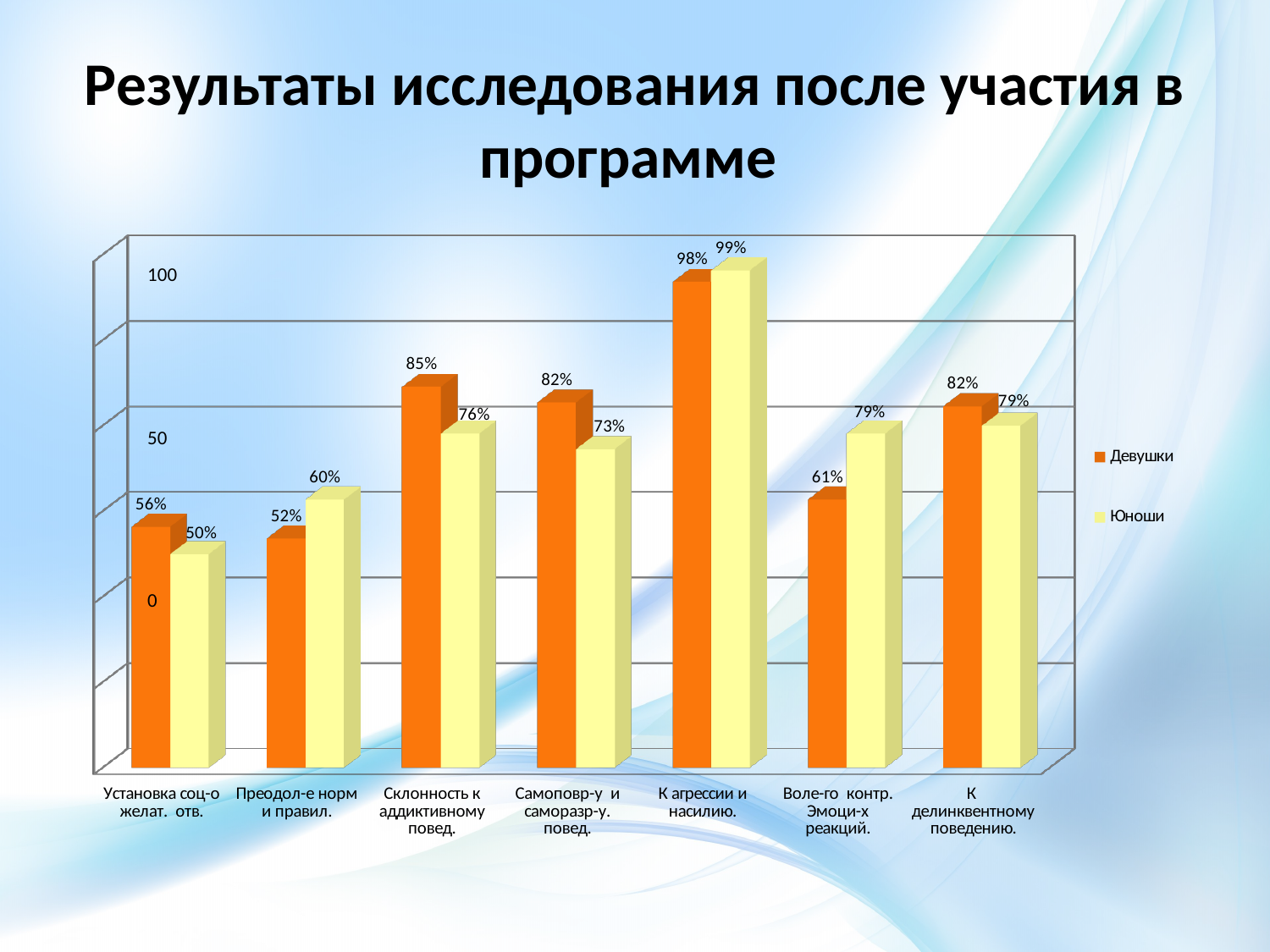
What is the value for Девушки in the category «К агрессии и насилию.»? 98% Which category has the highest value for Девушки? К агрессии и насилию. What kind of chart is shown on the slide? Bar chart What is the difference between the Девушки and Юноши values in the category «Воле-го контр. Эмоци-х реакций.»? 18% Which category has the lowest value for Юноши? Установка соц-о желат. отв. In the category «Самоповр-у и саморазр-у. повед.», which series has the larger value, Девушки or Юноши? Девушки How many series does the legend list? 2 What is the value for Девушки in the category «Склонность к аддиктивному повед.»? 85% How many categories are shown on the x axis of the chart? 7 What is the value for Юноши in the category «Преодол-е норм и правил.»? 60% What is the value for Юноши in the category «Воле-го контр. Эмоци-х реакций.»? 79% Which series is shown in orange in the chart? Девушки